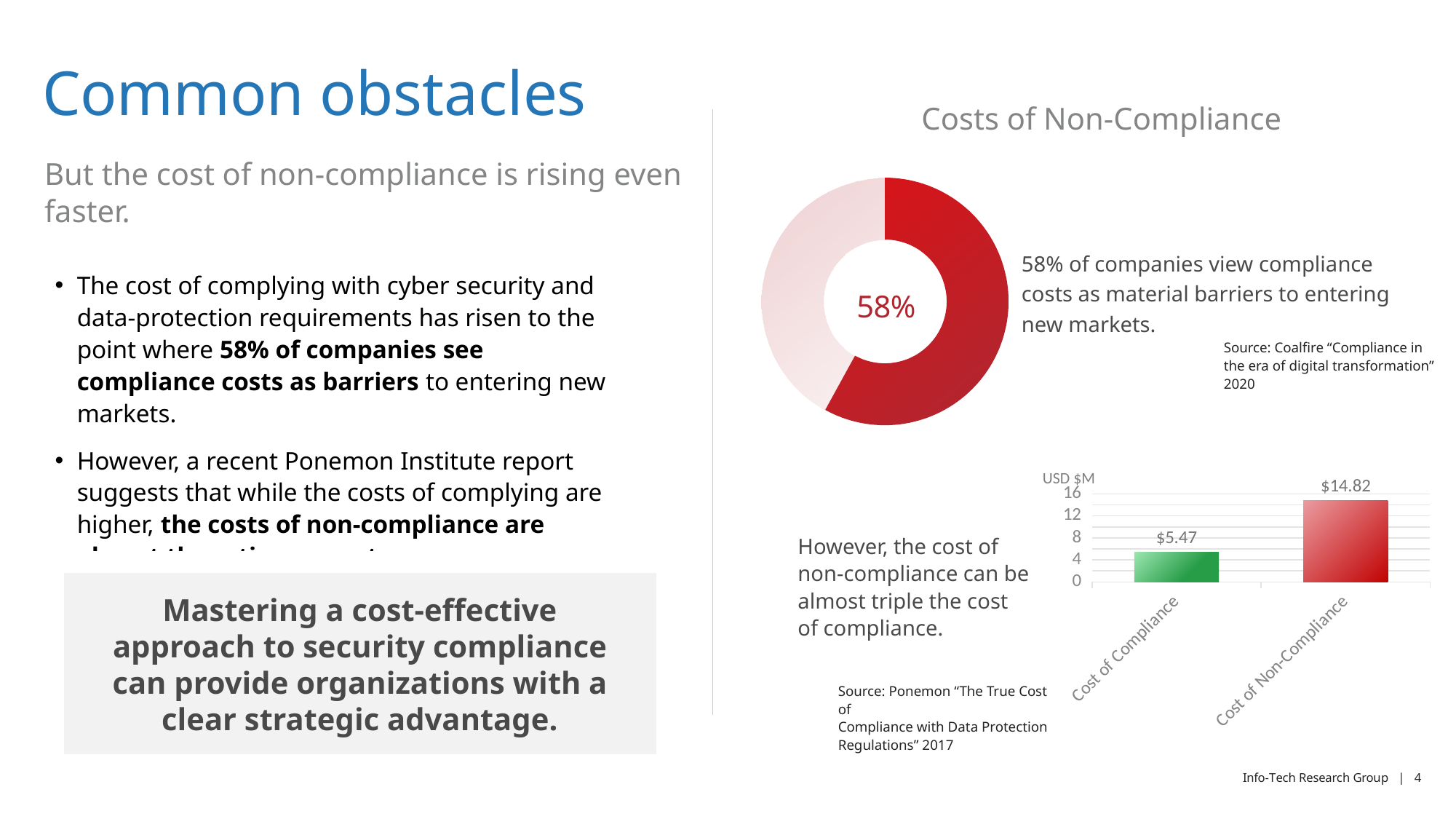
In the Costs of Non-Compliance donut chart, what share is shown by the red slice? 58% In the bar chart at the bottom right, what is the value for Cost of Non-Compliance? $14.82 In the bar chart at the bottom right, which category has the lowest value? Cost of Compliance In the bar chart at the bottom right, is the value for Cost of Compliance greater or less than 8? less What kind of chart is the Costs of Non-Compliance chart at the top right? donut chart In the bar chart at the bottom right, what is the difference between Cost of Non-Compliance and Cost of Compliance? $9.35 What kind of chart is the one at the bottom right of the slide? bar chart In the bar chart at the bottom right, what is the value for Cost of Compliance? $5.47 What unit is shown on the vertical axis of the bar chart at the bottom right? USD $M In the bar chart at the bottom right, is the value for Cost of Non-Compliance greater or less than 12? greater How many categories are shown in the bar chart at the bottom right? 2 In the bar chart at the bottom right, which category has the highest value? Cost of Non-Compliance